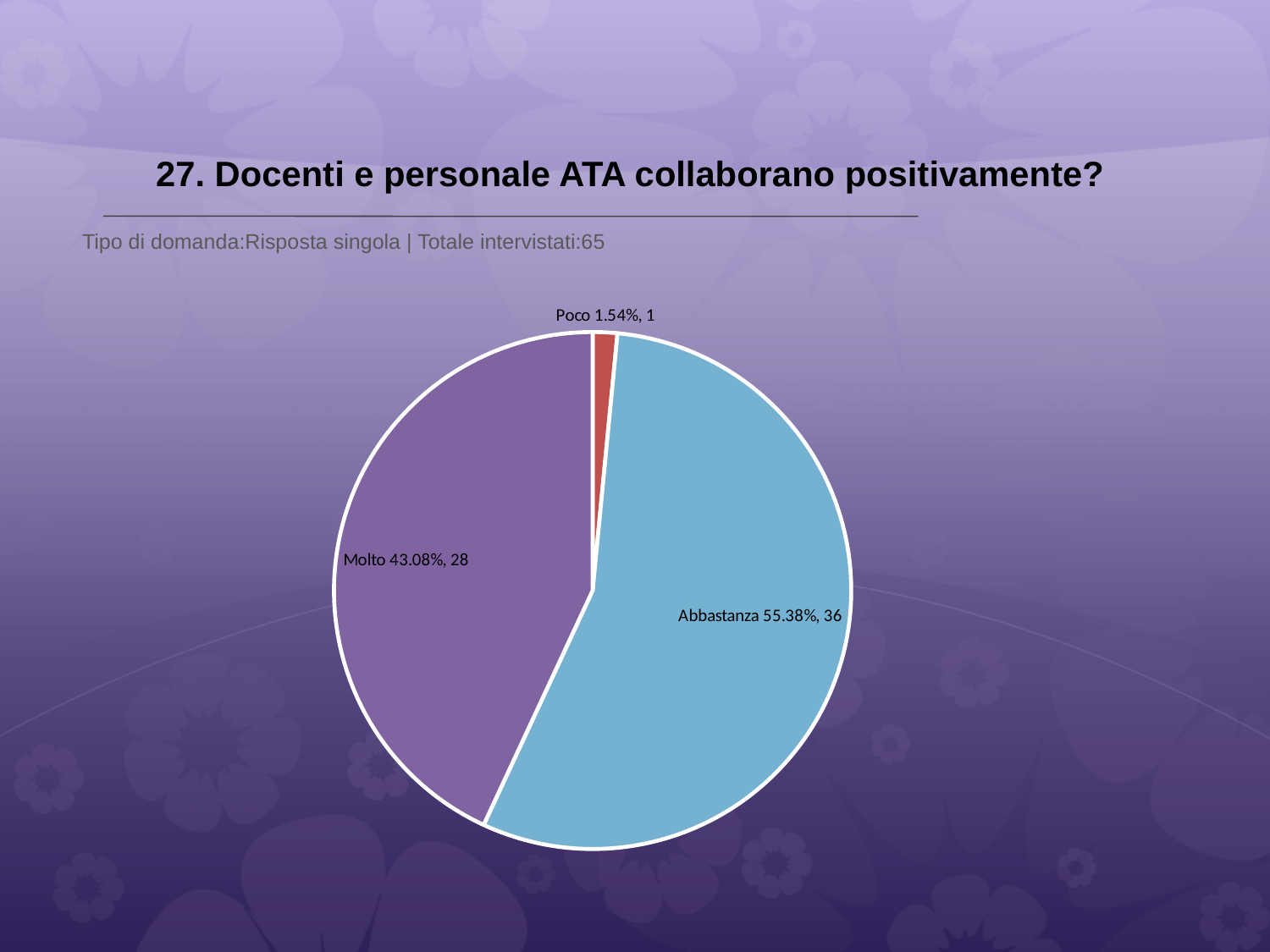
Which slice is larger, Molto or Poco? Molto How many slices does the pie chart have? 3 Which response has the largest slice of the pie? Abbastanza What percentage share does the Molto slice have? 43.08% What is the title of the chart on the slide? 27. Docenti e personale ATA collaborano positivamente? What is the difference in respondent count between Abbastanza and Molto? 8 How many respondents answered Poco? 1 Which response has the smallest slice of the pie? Poco What is the total number of respondents across all slices? 65 What kind of chart is shown on the slide? pie chart What percentage share does the Abbastanza slice have? 55.38% How many respondents answered Molto? 28